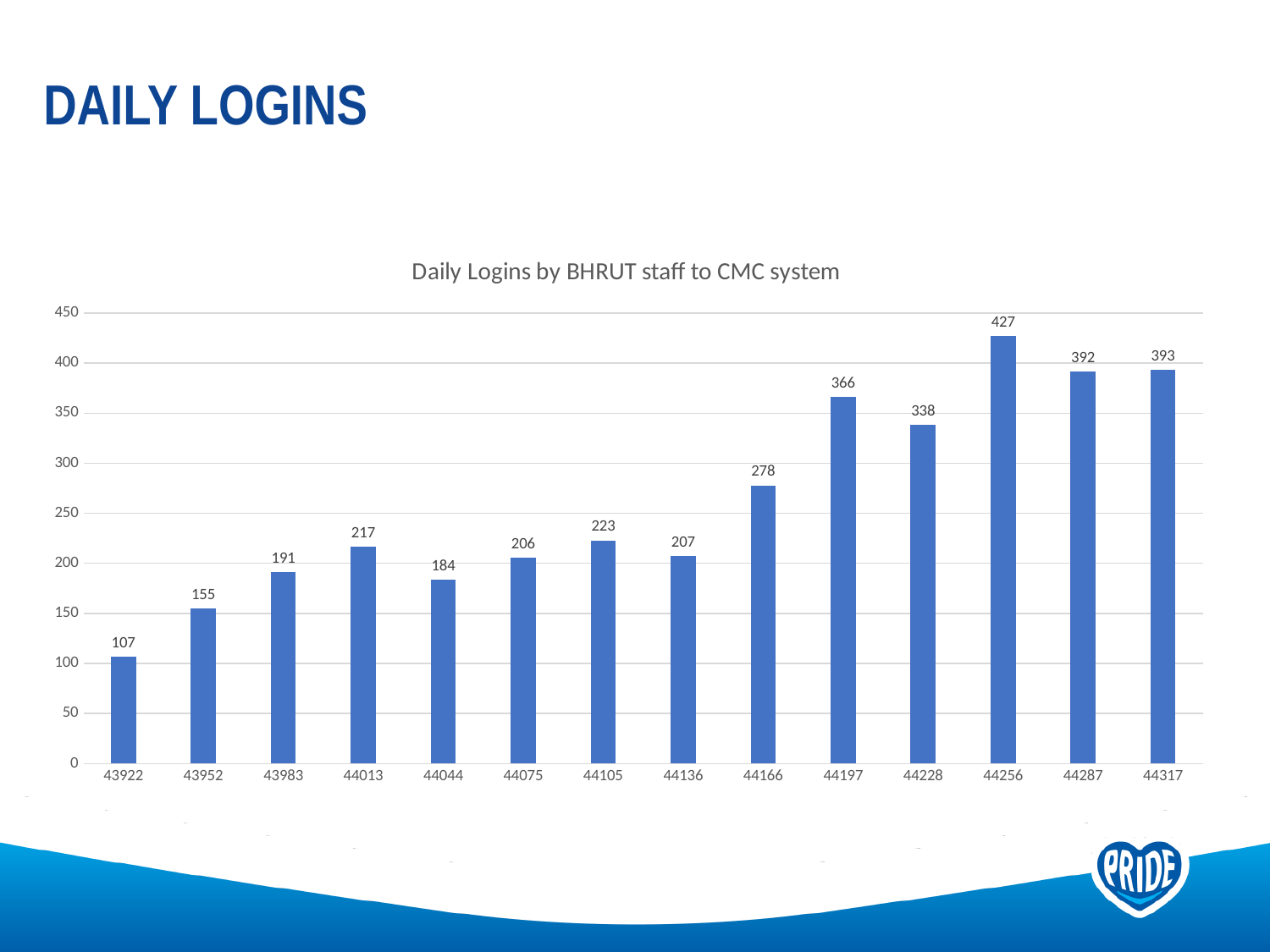
How many categories are shown on the x axis? 14 What is the difference between the values for 44256 and 44228? 89 Which category has the lowest value? 43922 Do the values generally rise or fall from left to right along the x axis? rise What kind of chart is this? bar chart What is the value for 43922? 107 What is the value for 44197? 366 Which is larger, the value for 44105 or the value for 44136? 44105 Which category has the highest value? 44256 Is the value for 44166 greater or less than 250? greater What is the value for 44044? 184 What is the title of the chart? Daily Logins by BHRUT staff to CMC system